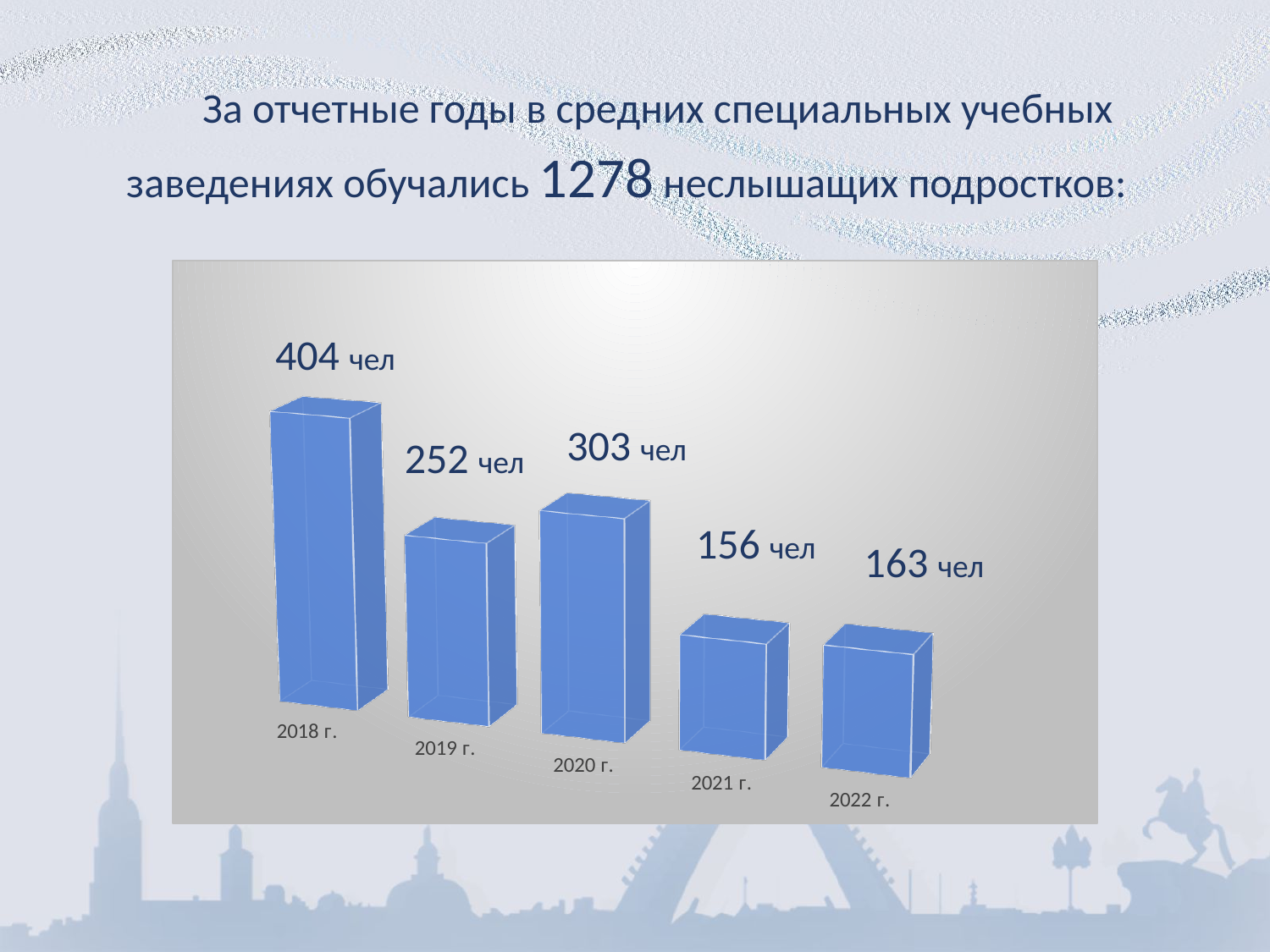
What value is shown for 2020 г.? 303 чел What is the difference between the values for 2018 г. and 2019 г.? 152 What is the difference between the values for 2022 г. and 2021 г.? 7 Which is larger, the value for 2019 г. or the value for 2020 г.? 2020 г. What kind of chart is shown on the slide? bar chart Which year has the lowest value? 2021 г. What value is shown for 2018 г.? 404 чел What is the total of all five values shown in the chart? 1278 How many years (bars) are shown in the chart? 5 Which year has the highest value? 2018 г. What colour are the bars in the chart? blue What value is shown for 2022 г.? 163 чел